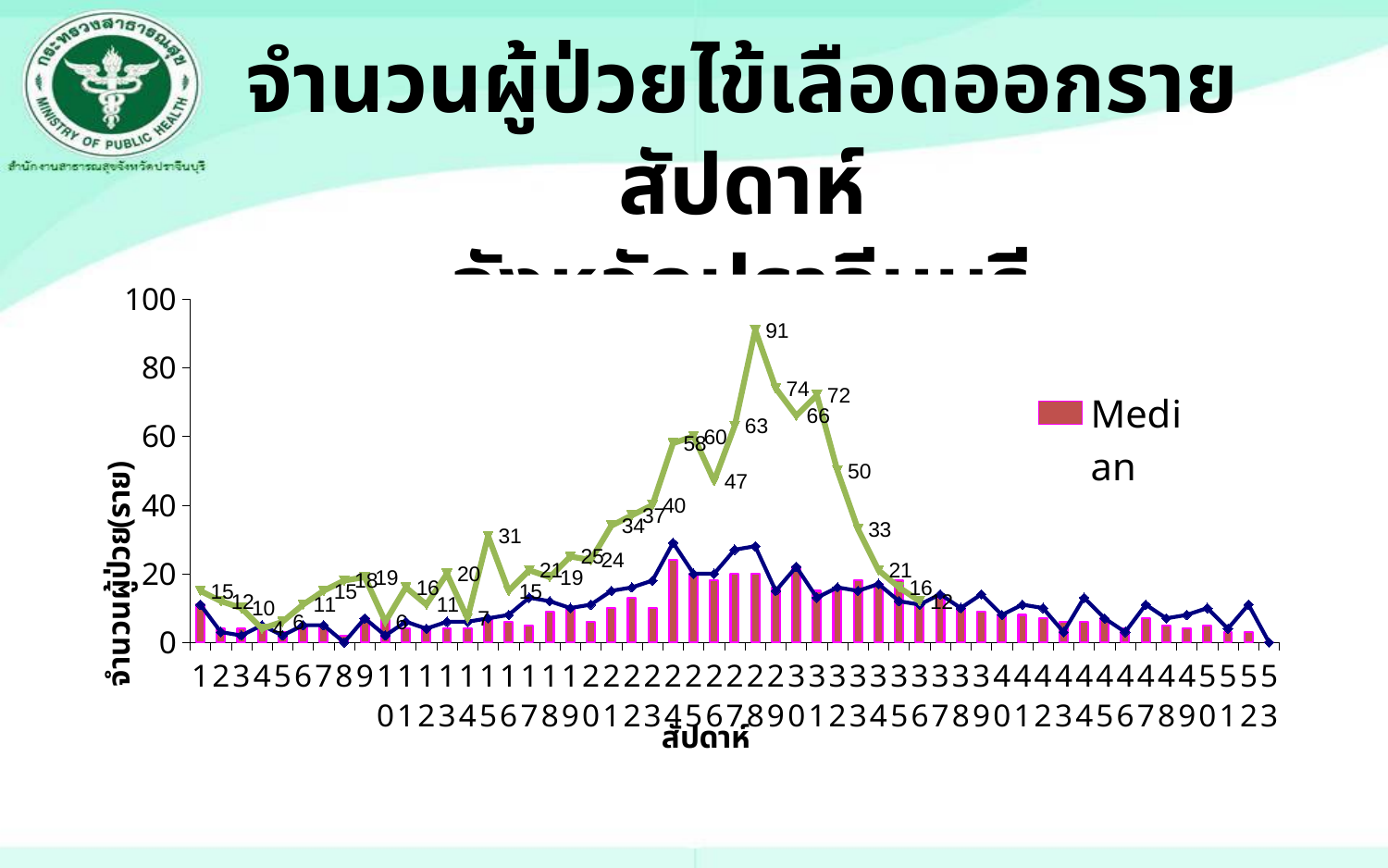
What is the highest value labelled on the green line? 91 Is the peak value of the green line greater or less than 80? greater What series name is shown in the chart legend? Median What is the lowest value labelled on the green line? 4 After reaching its peak of 91, does the green line rise or fall over the following weeks? fall How many series does the legend list? 1 What is the x-axis title of the chart? สัปดาห์ What is the difference between the green line's peak value of 91 and the next labelled value of 74? 17 Is the tallest Median bar greater or less than 40? less What is the difference between the labelled values 72 and 66 on the green line? 6 What kind of chart is shown on the slide? Combined bar and line chart Which labelled value on the green line is larger, 63 or 47? 63